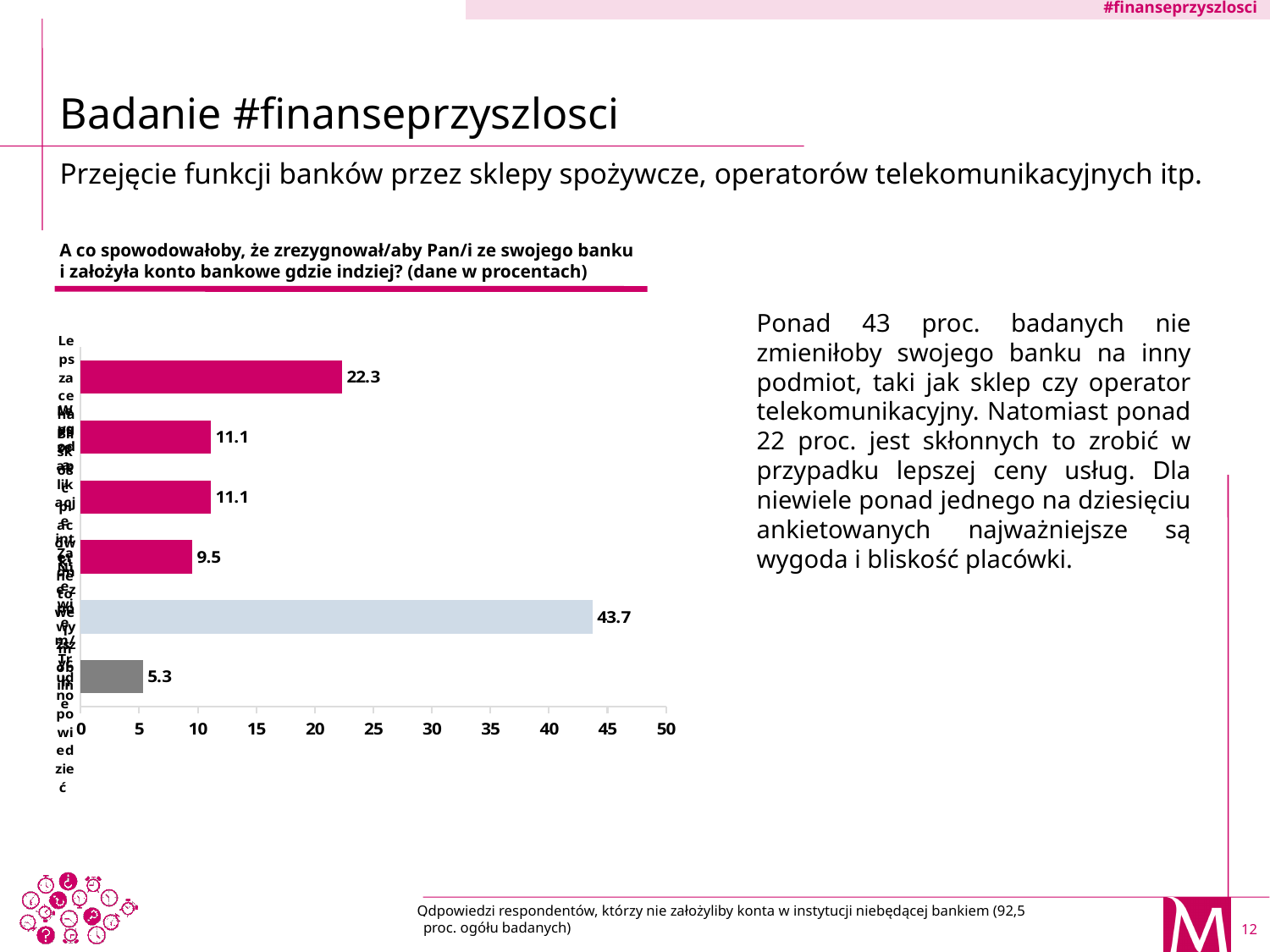
Which is larger: the value of the topmost bar or the value of the grey bottom bar? the topmost bar What kind of chart is shown on the slide? bar chart What is the highest value shown in the chart? 43.7 What is the value of the light blue bar in the chart? 43.7 How many bars does the chart contain? 6 What is the lowest value shown in the chart? 5.3 What is the value of the bottom bar in the chart? 5.3 What is the difference between the light blue bar (43.7) and the topmost bar (22.3)? 21.4 What is the maximum value shown on the horizontal axis of the chart? 50 What is the value of the topmost bar in the chart? 22.3 Is the value of the light blue bar greater or less than 40? greater What is the value of the fourth bar from the top? 9.5